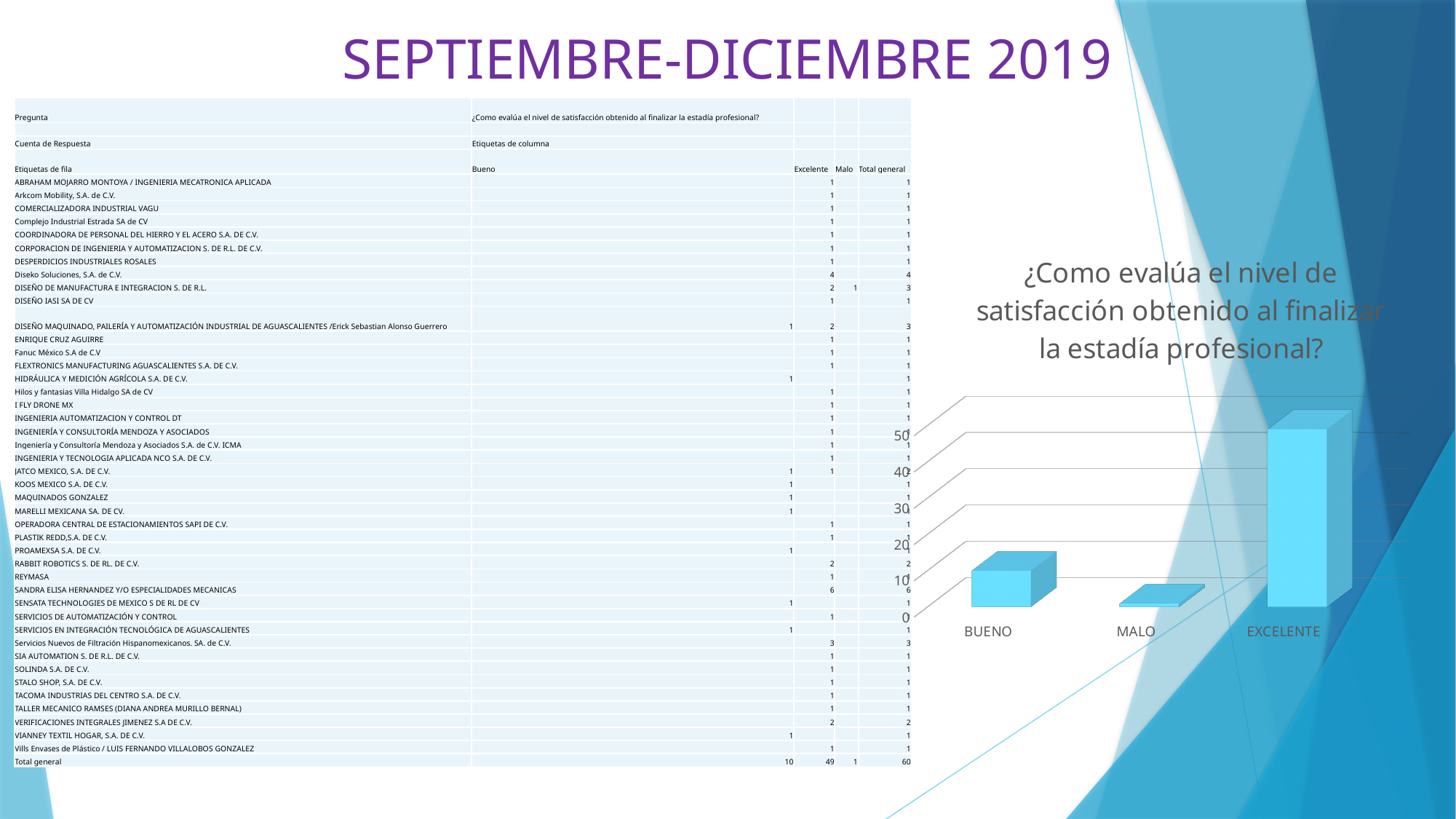
Is the value for BUENO greater or less than 20? less How many categories does the chart show? 3 What is the highest value shown on the chart's vertical axis? 50 Which category has the highest value in the chart? EXCELENTE Which is larger, the value for BUENO or the value for MALO? BUENO Is the value for EXCELENTE greater or less than 40? greater Which category has the lowest value in the chart? MALO Is the value for MALO greater or less than 10? less Which is larger, the value for EXCELENTE or the value for BUENO? EXCELENTE What question is the chart titled with? ¿Como evalúa el nivel de satisfacción obtenido al finalizar la estadía profesional? What kind of chart is shown on the slide? bar chart